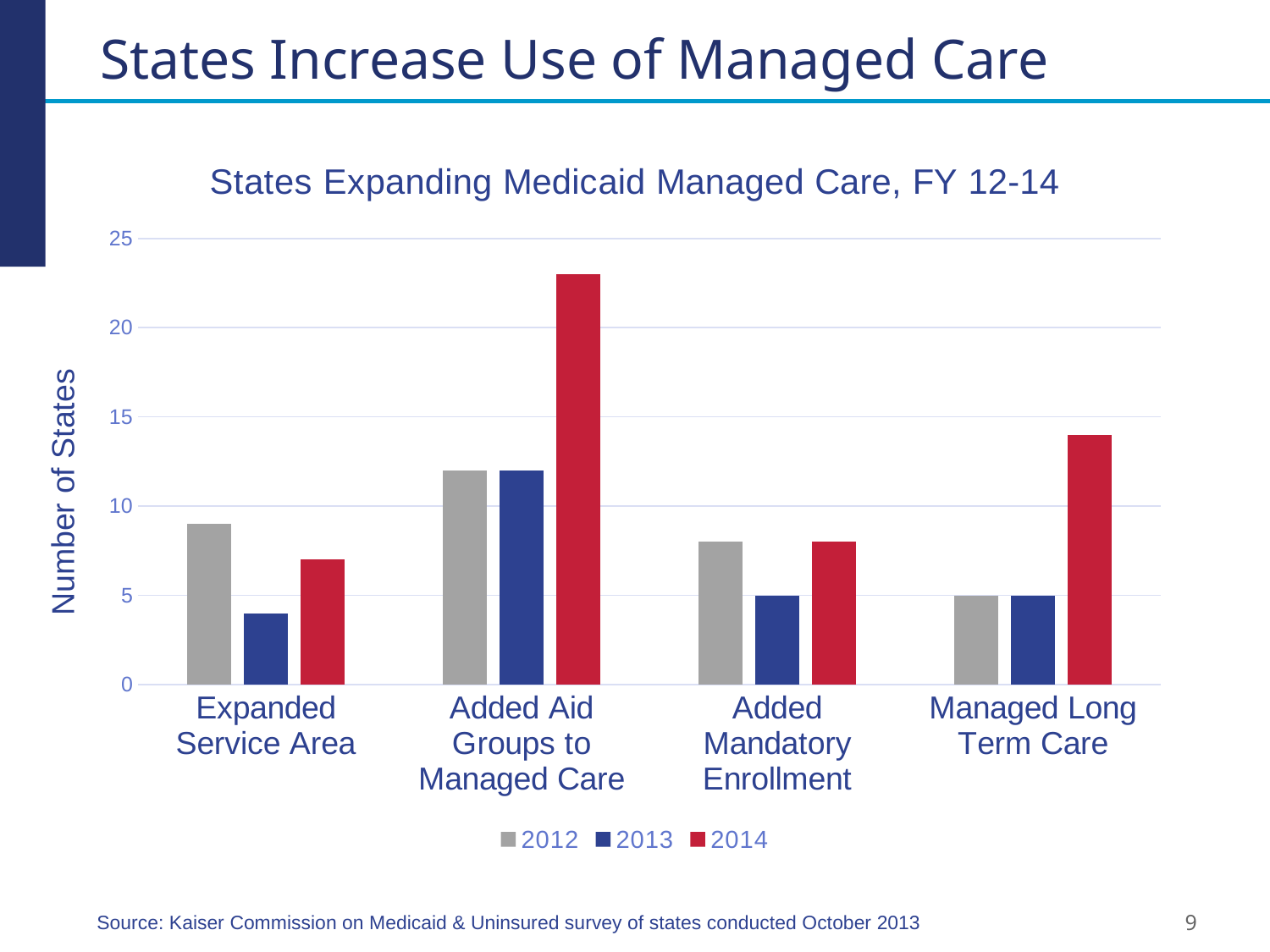
For 2014, which is larger: Managed Long Term Care or Expanded Service Area? Managed Long Term Care Which category and year has the shortest bar in the chart? Expanded Service Area, 2013 Is the 2014 value for Managed Long Term Care greater or less than 10? greater Which category and year has the tallest bar in the chart? Added Aid Groups to Managed Care, 2014 For Expanded Service Area, which year has the larger value: 2012 or 2013? 2012 Is the 2013 value for Expanded Service Area greater or less than 5? less Is the 2012 value for Added Mandatory Enrollment greater or less than 10? less What is the title of the chart? States Expanding Medicaid Managed Care, FY 12-14 How many series does the legend list? 3 What kind of chart is shown on the slide? bar chart How many categories are shown on the x axis of the chart? 4